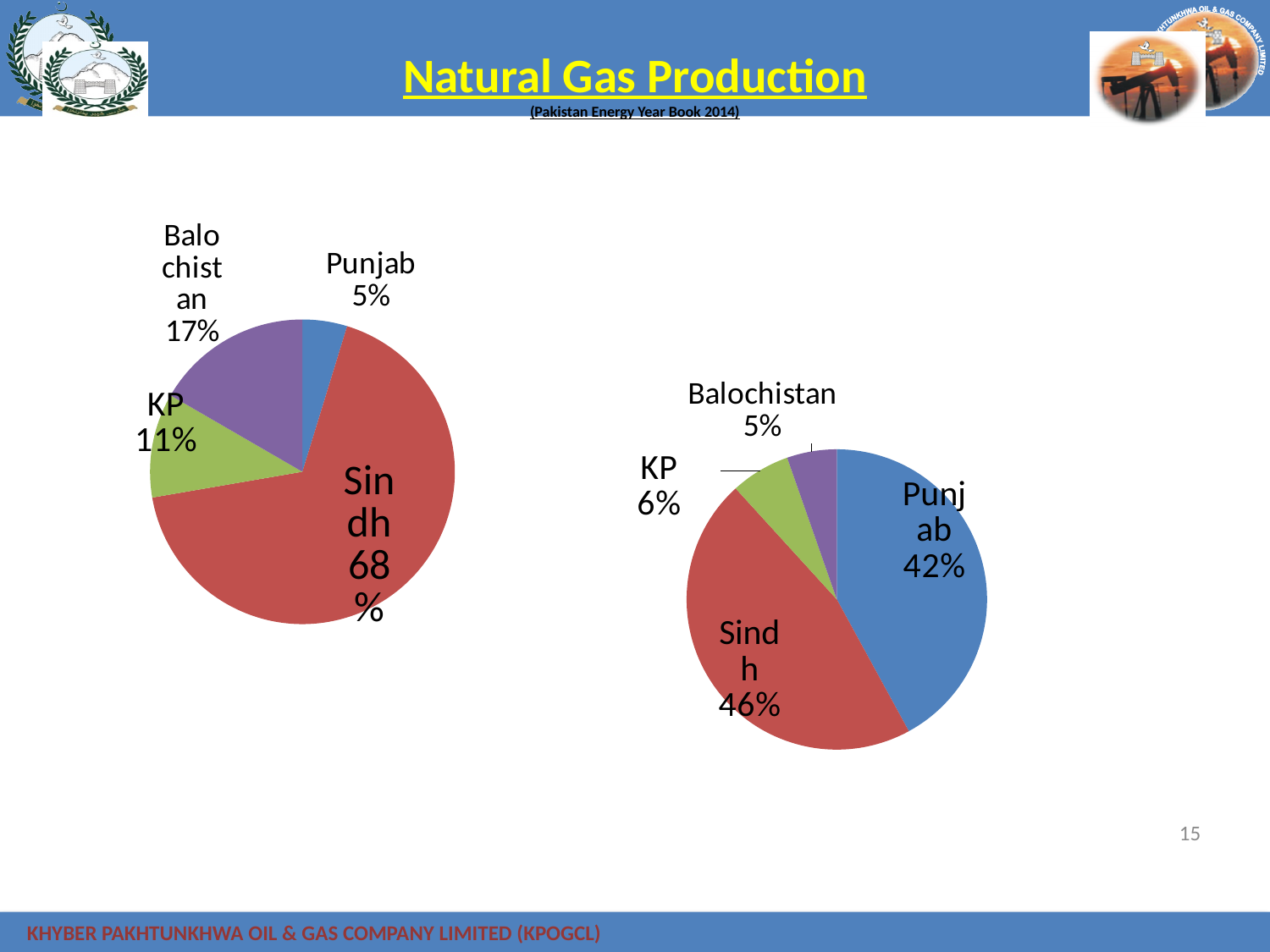
In the left pie chart, which region has the smallest share? Punjab In the right pie chart, which region has the largest share? Sindh In the right pie chart, what share does KP have? 6% In the right pie chart, what is the difference between the shares of Sindh and Punjab? 4% What type of chart is the right chart on the slide? Pie chart In the right pie chart, what share does Punjab have? 42% How many slices does the left pie chart have? 4 In the right pie chart, which is larger, the share of KP or the share of Balochistan? KP In the left pie chart, what share does Sindh have? 68% In the left pie chart, what share does Balochistan have? 17% In the left pie chart, which region has the largest share? Sindh In the left pie chart, what is the difference between the shares of Balochistan and KP? 6%